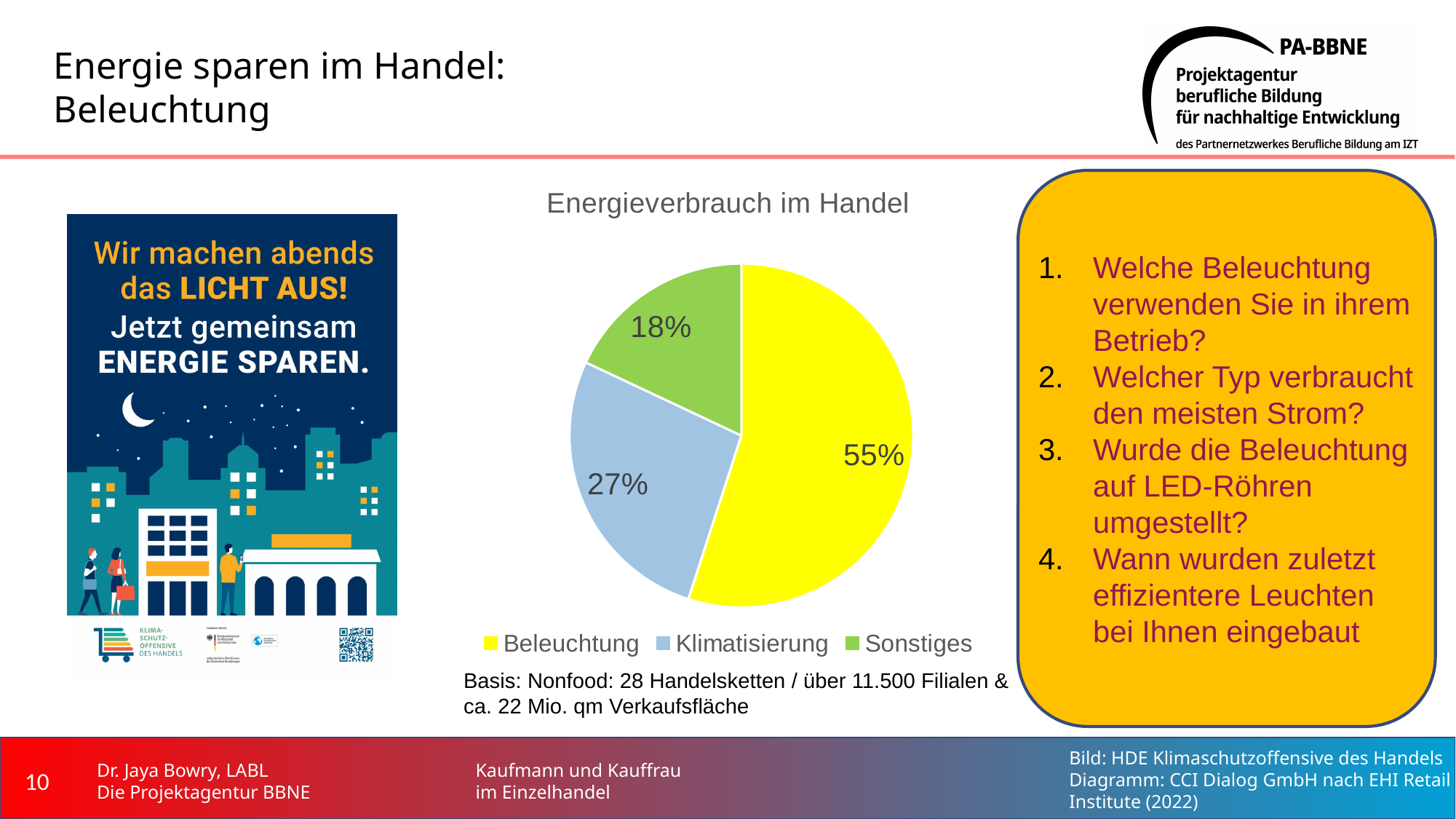
Which category has the smallest slice in the pie chart? Sonstiges What is the title of the chart? Energieverbrauch im Handel Which category has the largest slice in the pie chart? Beleuchtung What share of the pie chart does Beleuchtung account for? 55% What is the difference in percentage points between Beleuchtung and Klimatisierung? 28 What share of the pie chart does Klimatisierung account for? 27% Which is larger, the share for Klimatisierung or the share for Sonstiges? Klimatisierung How many categories are shown in the pie chart? 3 What share of the pie chart does Sonstiges account for? 18% What kind of chart is shown on the slide? Pie chart Which colour represents Klimatisierung in the pie chart? Light blue What is the difference in percentage points between Klimatisierung and Sonstiges? 9